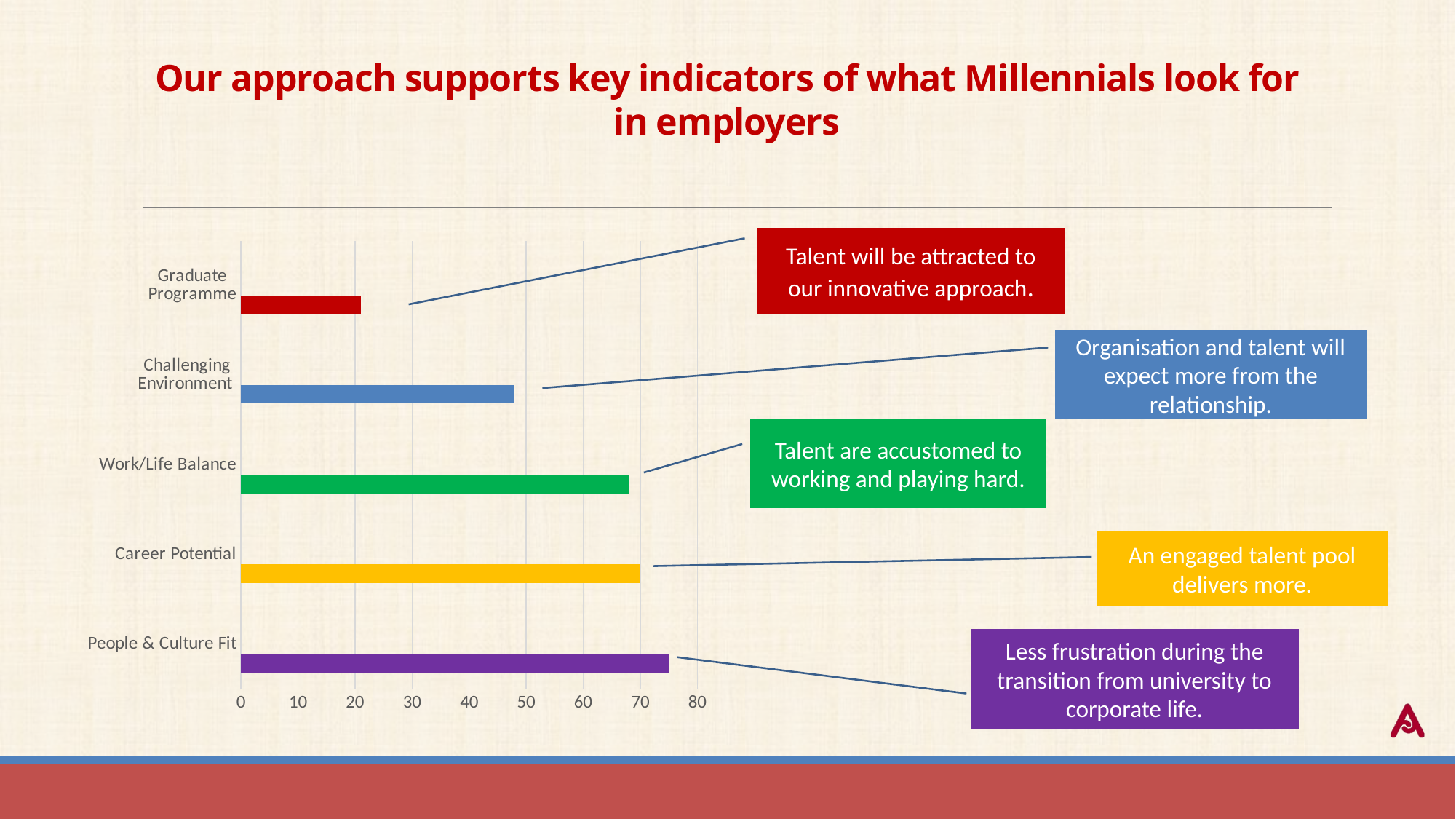
Which category has the lowest value in the chart? Graduate Programme Is the value for People & Culture Fit greater or less than 70? greater Is the value for Work/Life Balance greater or less than 60? greater Which is larger, the value for Work/Life Balance or the value for Challenging Environment? Work/Life Balance Which category has the highest value in the chart? People & Culture Fit What kind of chart is shown on the slide? bar chart What colour is the bar for Work/Life Balance? green What is the highest tick value shown on the horizontal axis of the chart? 80 Is the value for Graduate Programme greater or less than 30? less Which is larger, the value for Career Potential or the value for Graduate Programme? Career Potential How many categories are plotted in the chart? 5